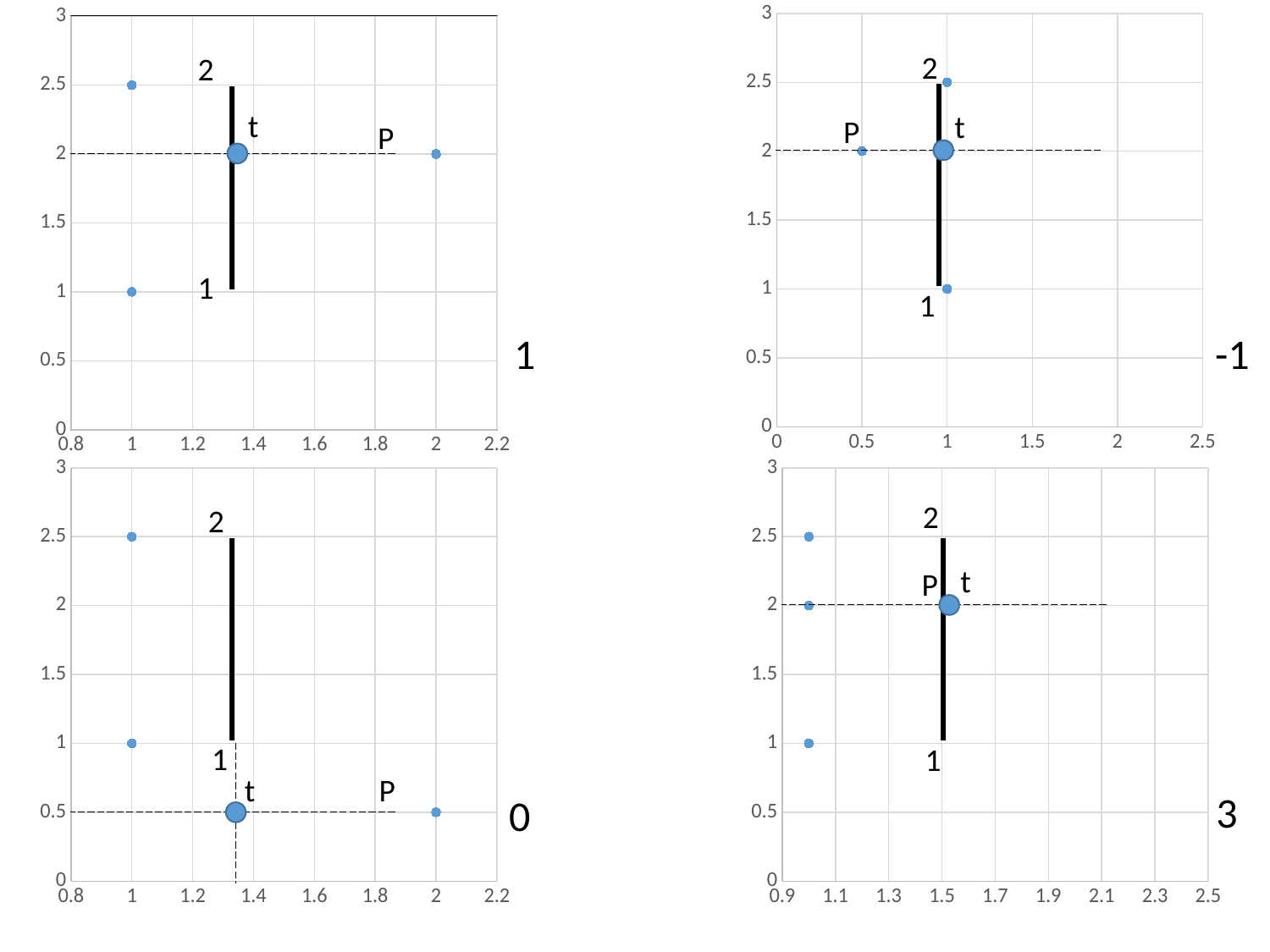
In the top-right chart, is the x value of the point labelled P greater or less than 1? less What kind of chart is the top-left chart? scatter chart What number is printed to the right of the bottom-right chart? 3 In the bottom-left chart, is the point labelled t above or below the lower end of the thick vertical segment (labelled 1)? below In the top-left chart, is the x value of the point labelled t greater or less than 1.2? greater How many charts are on the slide? 4 In the top-left chart, what is the y value of the large point labelled t? 2 In the top-right chart, what is the y value of the point labelled P? 2 What number is printed to the right of the top-right chart? -1 In the bottom-right chart, is the x value of the point labelled t greater or less than 1.3? greater In the bottom-left chart, what is the y value of the large point labelled t? 0.5 What is the largest value shown on the x axis of the top-right chart? 2.5